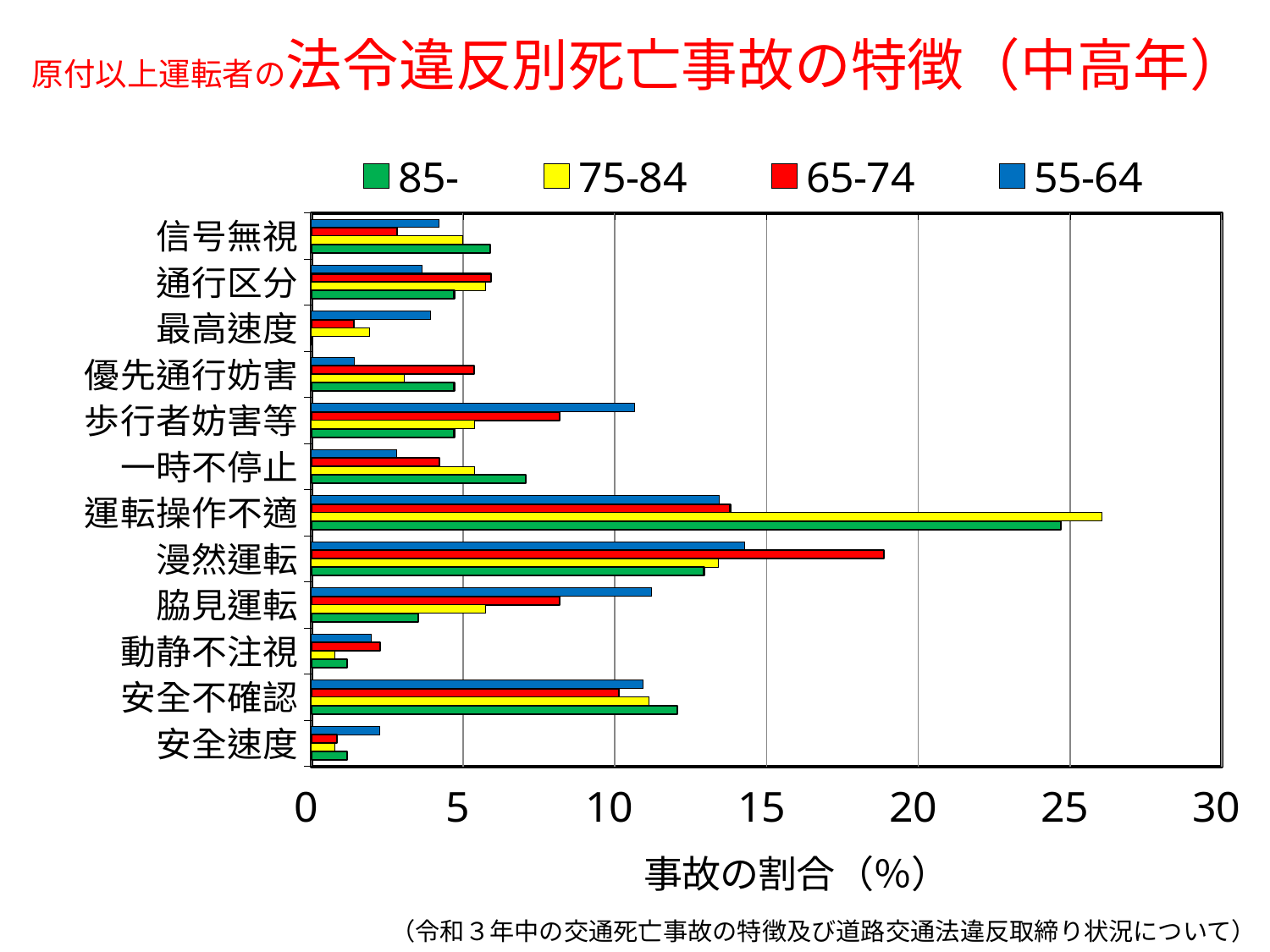
For the 85- series, which category has the highest value? 運転操作不適 For the 65-74 series, which category has the highest value? 漫然運転 What kind of chart is shown on the slide? bar chart Is the value for 運転操作不適 in the 75-84 series greater or less than 25? greater What is the title of the x axis? 事故の割合（%） How many violation categories are plotted on the y axis? 12 For the 75-84 series, which category has the highest value? 運転操作不適 Which age group series is shown in yellow in the legend? 75-84 For 漫然運転, which series has the larger value, 65-74 or 55-64? 65-74 How many series does the legend list? 4 Is the value for 安全速度 in the 85- series greater or less than 5? less Is the value for 漫然運転 in the 65-74 series greater or less than 15? greater